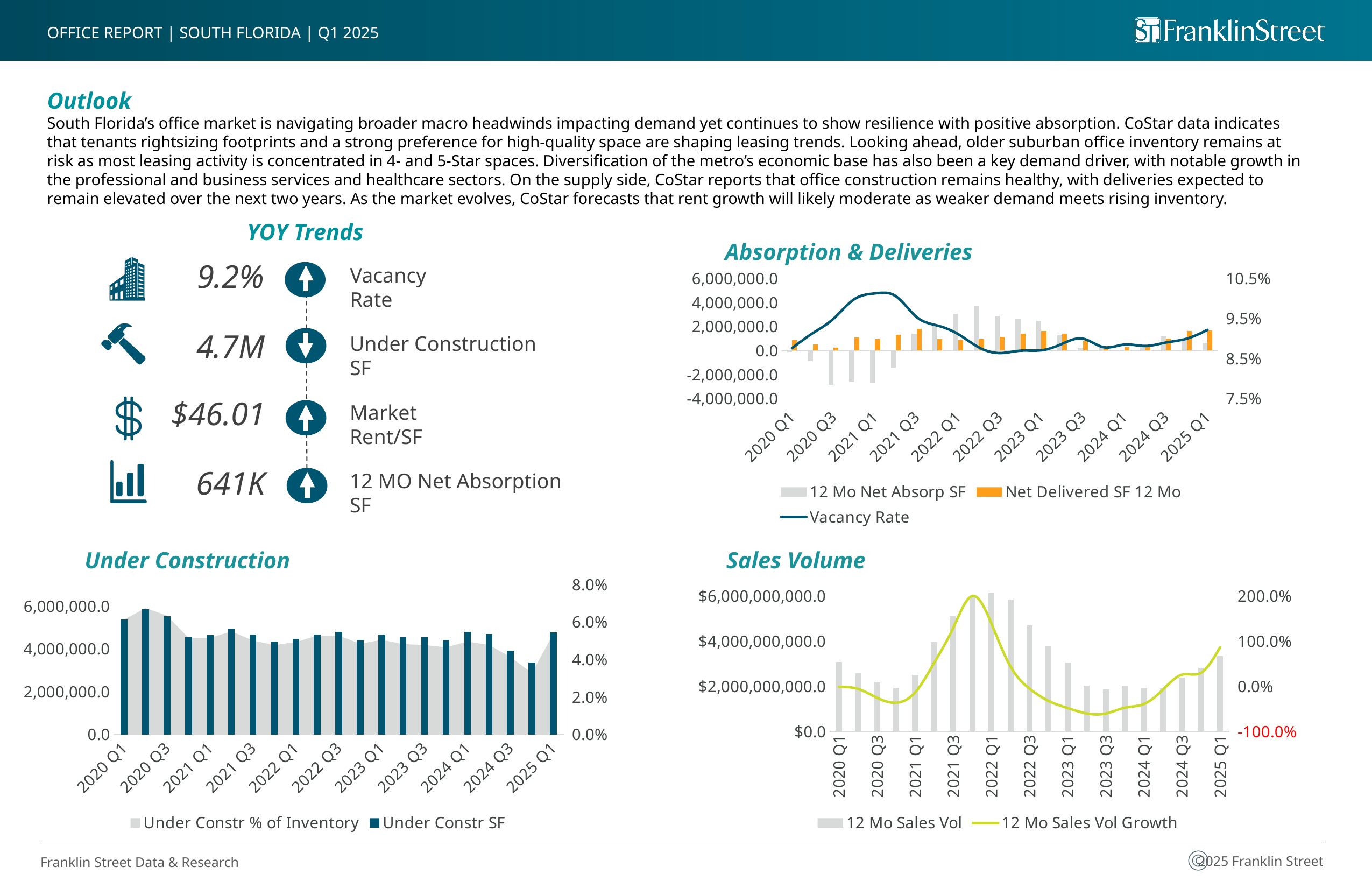
In the Absorption & Deliveries chart, is the 12 Mo Net Absorp SF value at 2020 Q3 greater or less than 0.0? less In the Absorption & Deliveries chart, at which quarter does the Vacancy Rate line reach its highest point? 2021 Q1 In the Under Construction chart, is the Under Constr SF value for 2024 Q4 greater or less than 4,000,000.0? less What kind of chart is the Sales Volume chart? Combination bar and line chart In the Under Construction chart, which quarter has the lowest Under Constr SF bar? 2024 Q4 In the Under Construction chart, how many quarters are plotted on the x axis? 21 In the Sales Volume chart, is the 12 Mo Sales Vol Growth value at 2023 Q3 greater or less than 0.0%? less In the Absorption & Deliveries chart, how many series does the legend list? 3 In the Under Construction chart, which is larger: the Under Constr SF bar for 2020 Q1 or for 2025 Q1? 2020 Q1 In the Sales Volume chart, which quarter has the highest 12 Mo Sales Vol bar? 2022 Q1 In the Under Construction chart, which quarter has the highest Under Constr SF bar? 2020 Q2